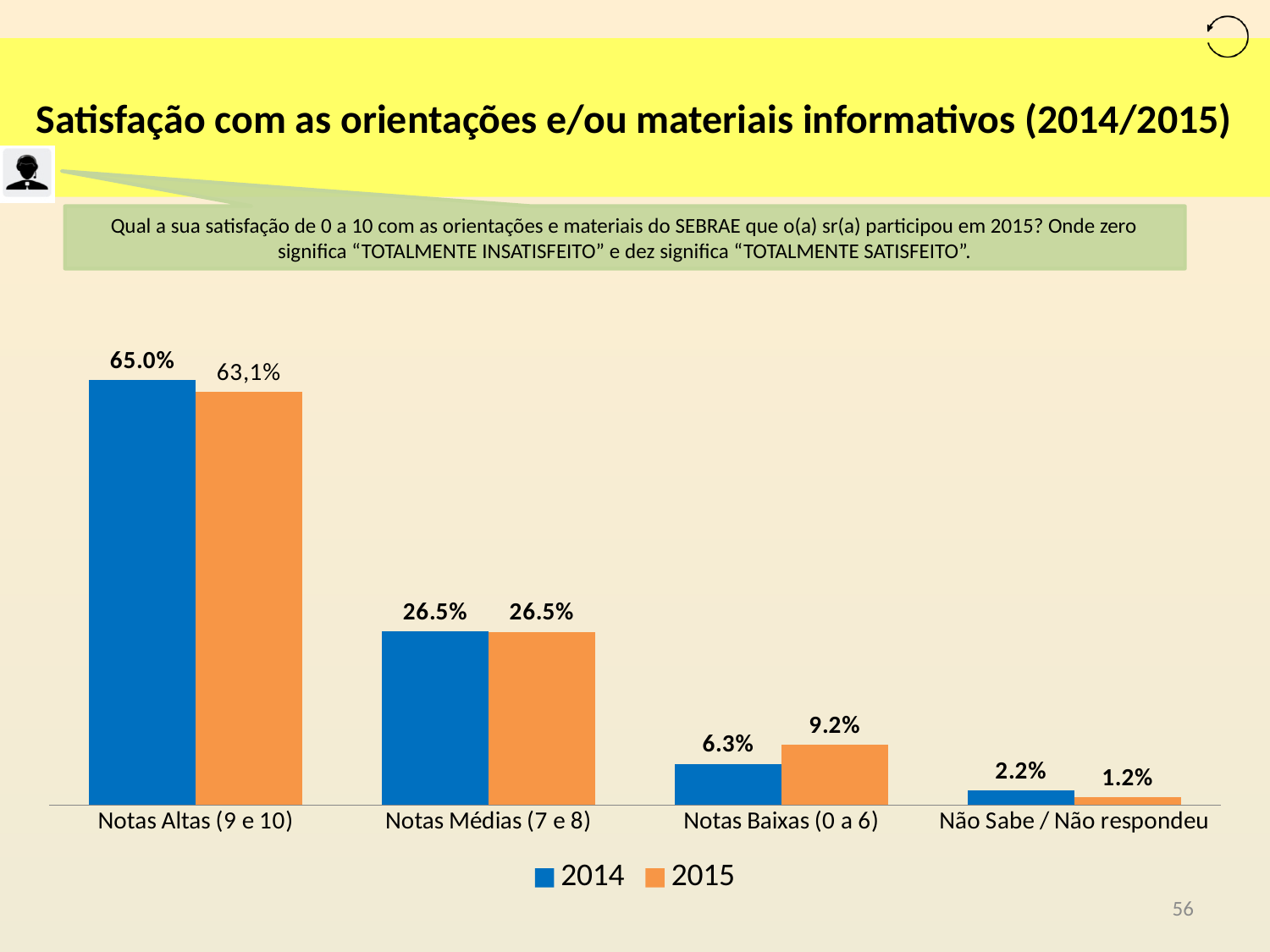
Which category has the highest value for 2014? Notas Altas (9 e 10) What is the value for 2015 in the Notas Altas (9 e 10) category? 63,1% Which category has the lowest value for 2015? Não Sabe / Não respondeu What kind of chart is shown on the slide? Bar chart What is the value for 2014 in the Não Sabe / Não respondeu category? 2.2% How many categories are shown on the x axis? 4 What is the value for 2014 in the Notas Altas (9 e 10) category? 65.0% Which colour represents the 2015 series? Orange In the Notas Baixas (0 a 6) category, which series has the larger value, 2014 or 2015? 2015 What is the difference between the 2015 and 2014 values in the Notas Baixas (0 a 6) category? 2.9% What is the value for 2015 in the Notas Baixas (0 a 6) category? 9.2% How many series does the legend list? 2